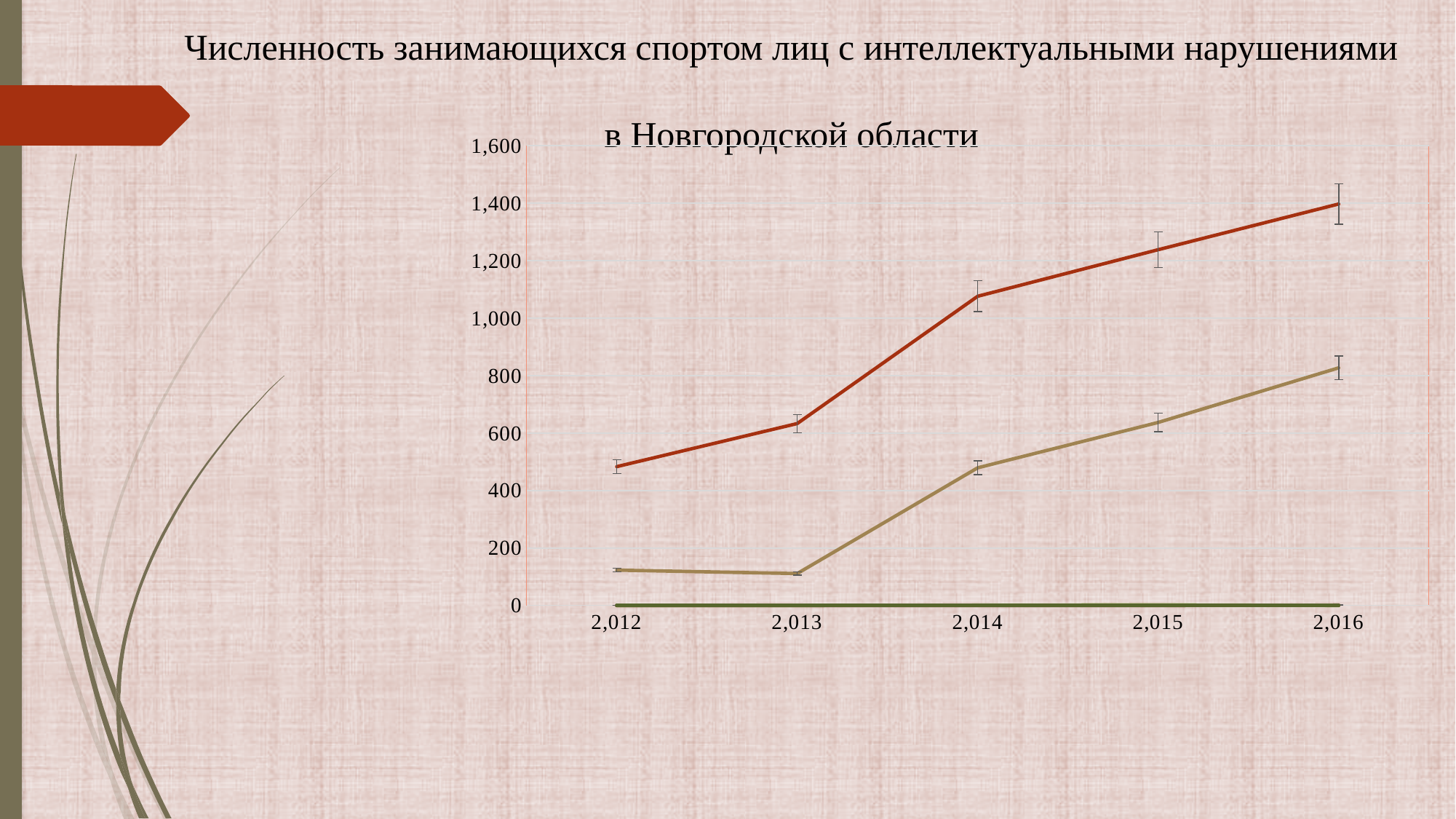
What kind of chart is shown on the slide? line chart In which year does the red line have its lowest value? 2,012 In which year does the tan line reach its highest value? 2,016 What is the title of the chart? Численность занимающихся спортом лиц с интеллектуальными нарушениями в Новгородской области Does the red line rise or fall from 2,012 to 2,016? rise Is the value of the red line in 2,014 greater or less than 1,000? greater Is the value of the red line in 2,012 greater or less than 600? less In which year does the red line reach its highest value? 2,016 How many years are shown on the x axis of the chart? 5 Which line has the larger value in 2,014, the red line or the tan line? the red line Is the value of the tan line in 2,012 greater or less than 200? less How many lines are plotted on the chart? 3